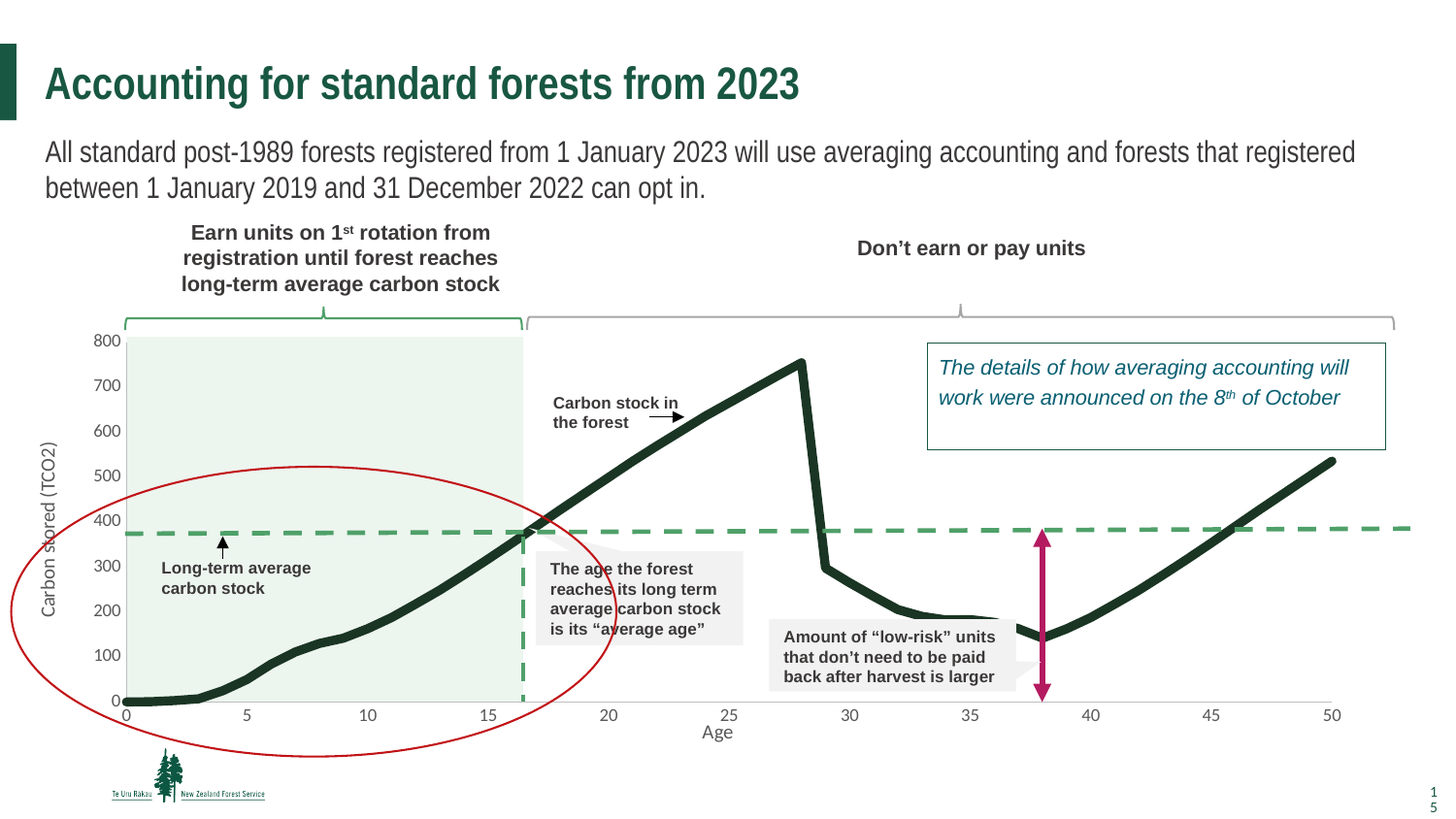
What is the carbon stock in the forest at age 0? 0 Is the carbon stock in the forest at age 20 greater or less than 400? greater Is the carbon stock in the forest at age 38 greater or less than 200? less What is the label of the vertical axis of the chart? Carbon stored (TCO2) Does the carbon stock in the forest rise or fall between age 40 and age 50? rise Is the carbon stock in the forest at age 50 greater or less than 400? greater Does the carbon stock in the forest rise or fall between age 0 and age 25? rise What kind of chart is shown on the slide? line chart What is the highest value shown on the vertical axis of the chart? 800 What is the label of the horizontal axis of the chart? Age